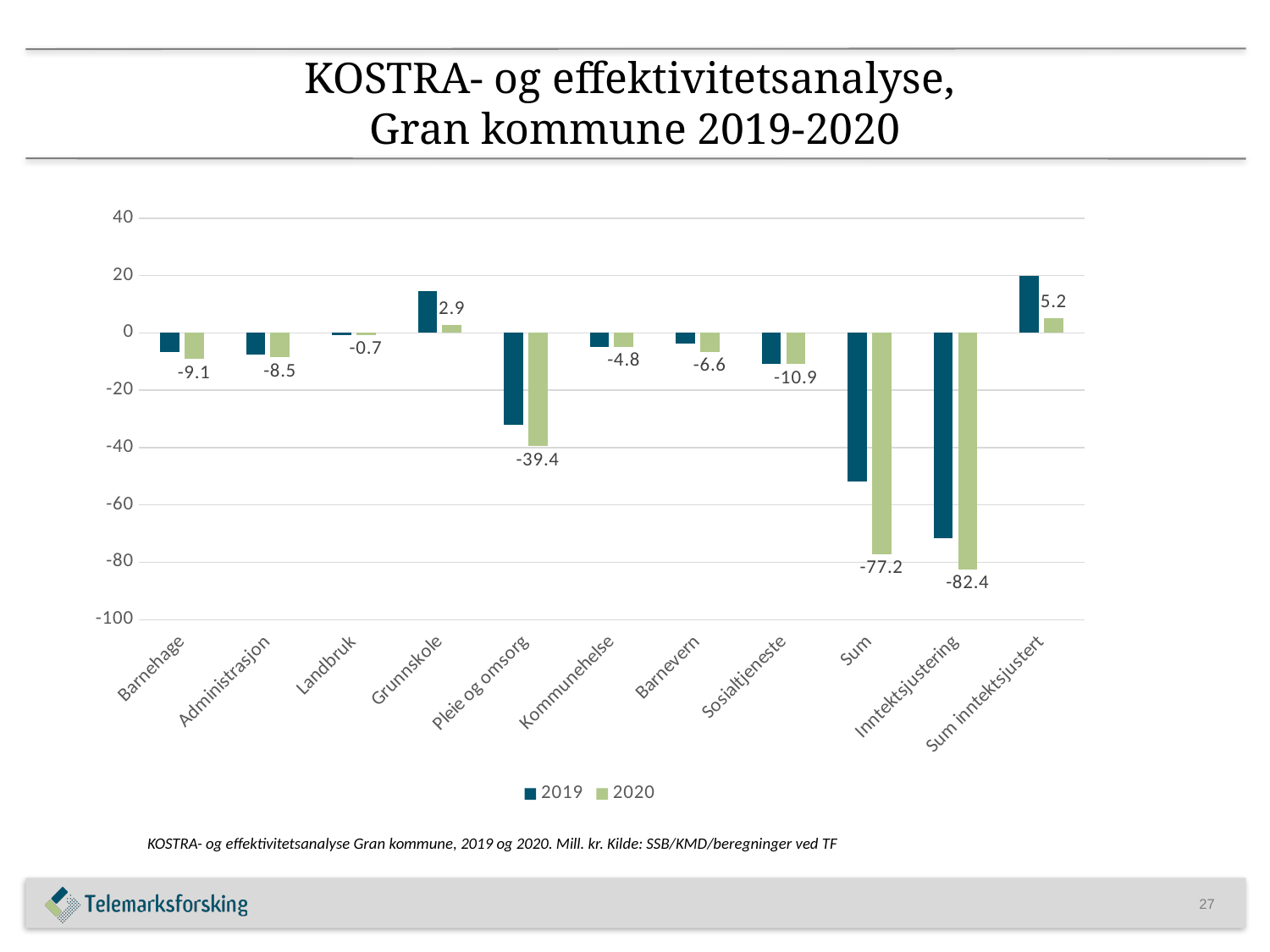
Which is larger, the 2020 value for Barnehage or the 2020 value for Administrasjon? Administrasjon What is the 2020 value for Landbruk? -0.7 Which category has the lowest 2020 value? Inntektsjustering What is the 2020 value for Pleie og omsorg? -39.4 Is the 2019 value for Sum greater or less than -40? less What is the 2020 value for Sum inntektsjustert? 5.2 How many series does the legend list? 2 How many categories are shown on the x axis? 11 Is the 2019 value for Inntektsjustering greater or less than -60? less What is the 2020 value for Inntektsjustering? -82.4 What is the difference between the 2020 values for Sum and Inntektsjustering? 5.2 Which category has the highest 2020 value? Sum inntektsjustert